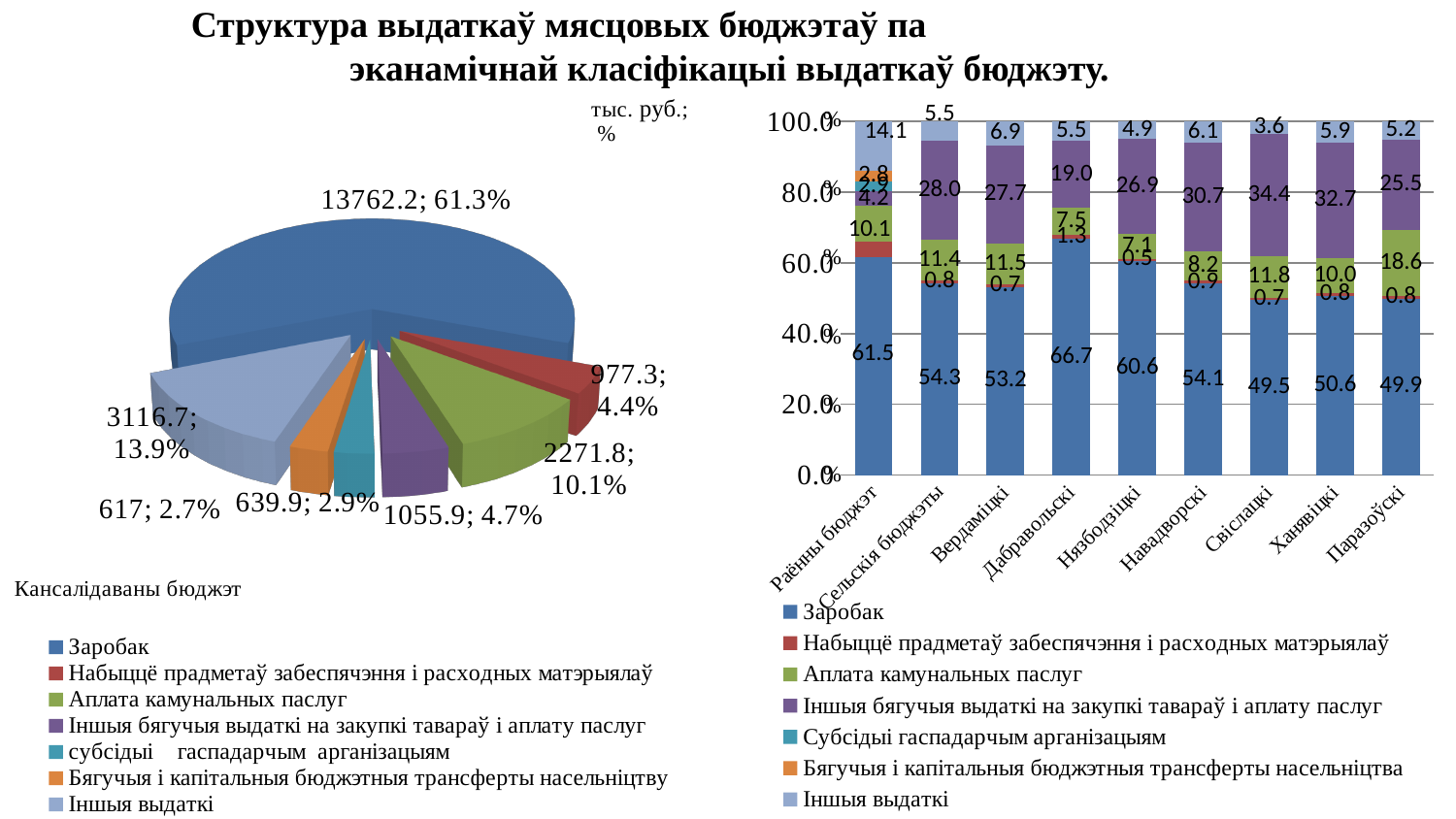
On the stacked bar chart, what is the value of Заробак for Дабравольскі? 66.7 How many series does the legend of the stacked bar chart list? 7 On the stacked bar chart, which category has the lowest Заробак value? Свіслацкі On the pie chart, what share does Іншыя выдаткі have? 13.9% On the pie chart, how many slices are there? 7 On the stacked bar chart, which category has the highest Заробак value? Дабравольскі On the pie chart, which category has the smallest share? Бягучыя і капітальныя бюджэтныя трансферты насельніцтву (617; 2.7%) On the stacked bar chart, how many categories are shown on the x axis? 9 On the pie chart, what value is shown for Аплата камунальных паслуг? 2271.8 On the pie chart (Кансалідаваны бюджэт), what value and share are shown for Заробак? 13762.2; 61.3% On the stacked bar chart, what is the difference between the Заробак values for Раённы бюджэт and Сельскія бюджэты? 7.2 What type of chart is the chart on the right? Stacked bar chart